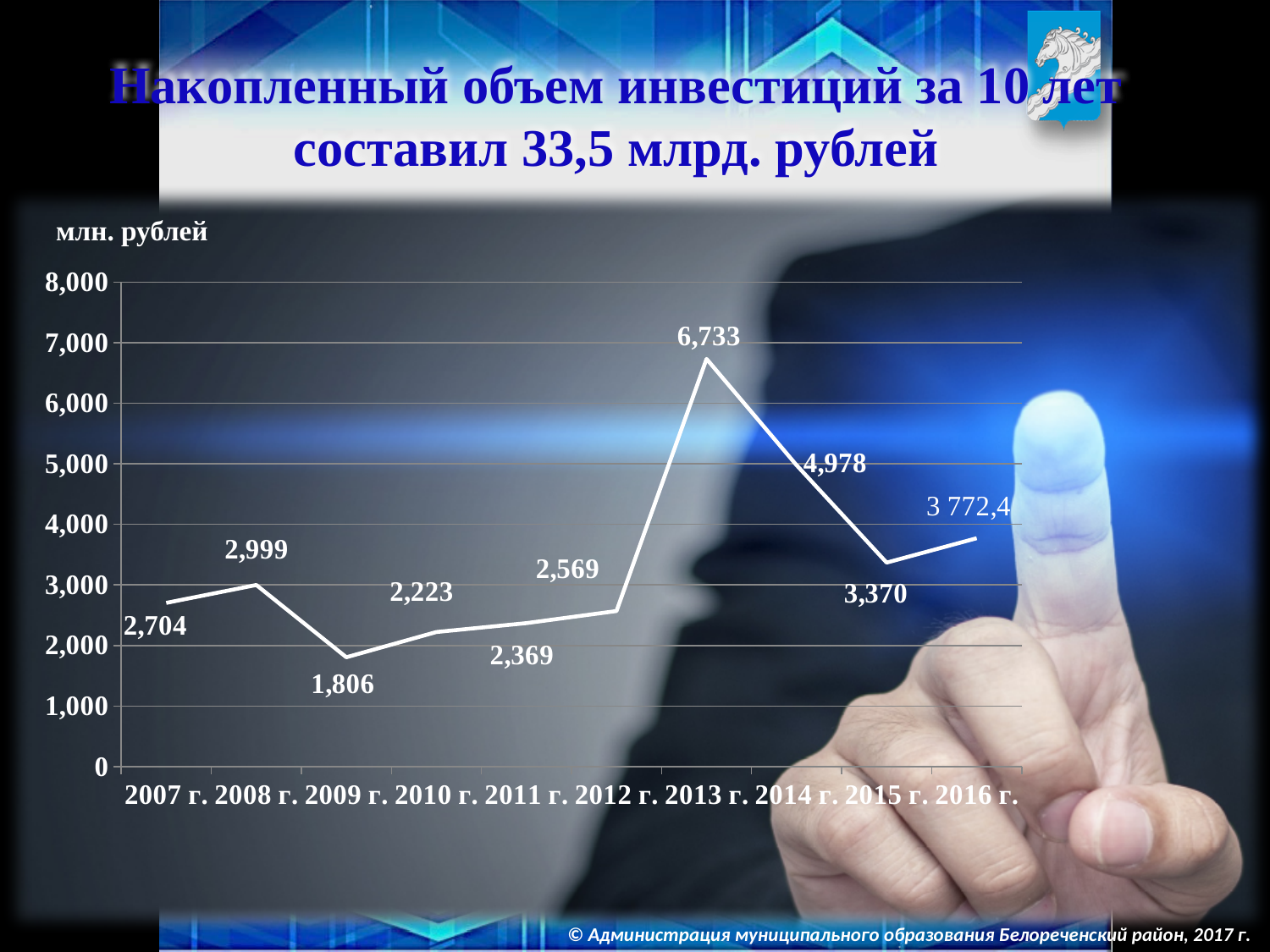
What unit is shown above the chart's vertical axis? млн. рублей What is the value for 2016 г.? 3 772,4 What is the value for 2013 г.? 6,733 Which is larger, the value for 2008 г. or the value for 2012 г.? 2008 г. What type of chart is shown on the slide? line chart What is the value for 2009 г.? 1,806 Which year has the lowest value? 2009 г. How many years are plotted on the x axis? 10 Do the values rise or fall from 2013 г. to 2015 г.? fall What is the difference between the values for 2013 г. and 2014 г.? 1,755 What is the value for 2007 г.? 2,704 Which year has the highest value? 2013 г.